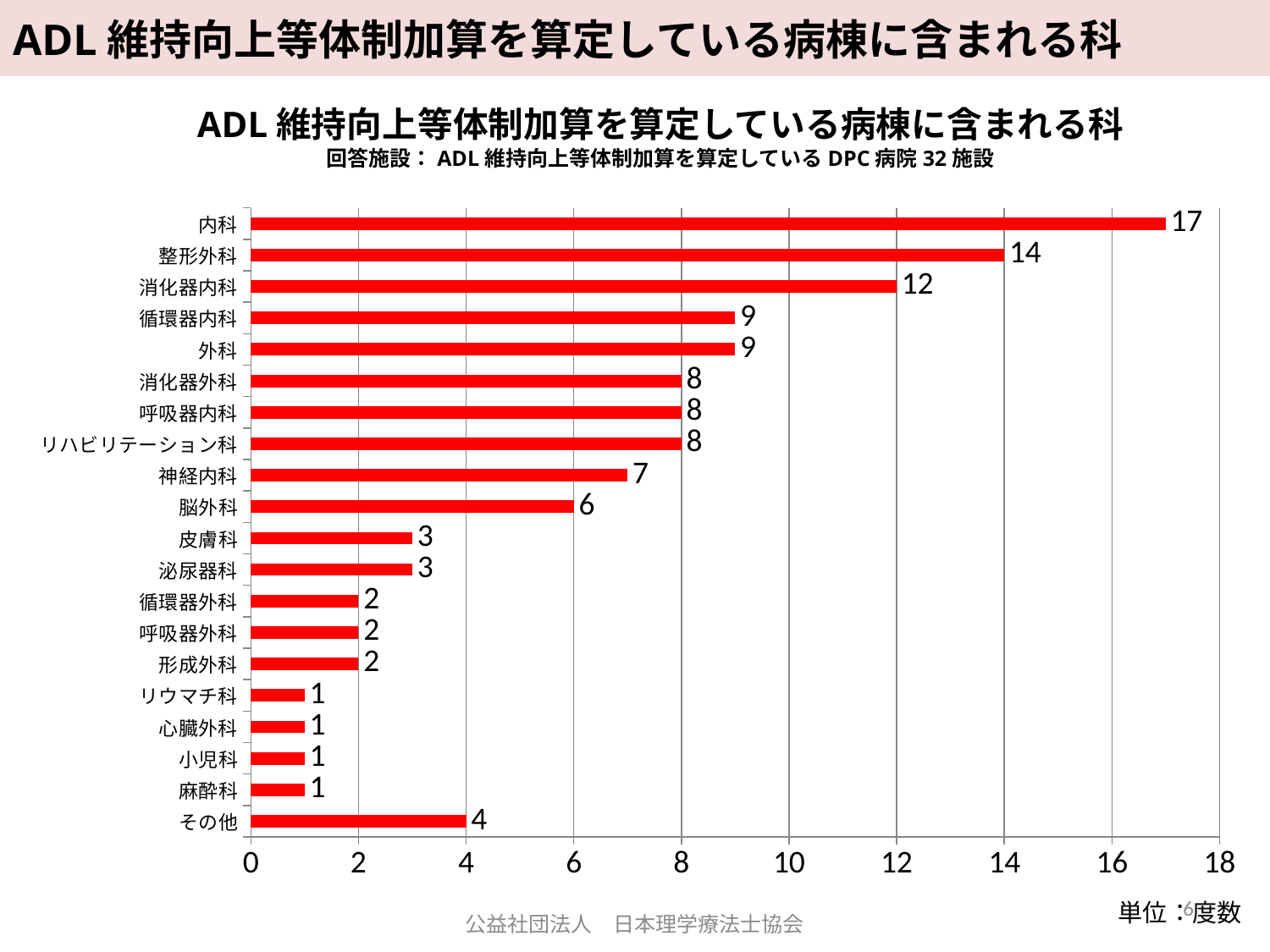
What is the value for 神経内科? 7 What is the value for 消化器内科? 12 What is the maximum value shown on the horizontal axis? 18 What is the value for その他? 4 What kind of chart is shown on the slide? bar chart What is the difference between the values for 脳外科 and 皮膚科? 3 How many categories are shown on the chart? 20 What is the difference between the values for 内科 and 整形外科? 3 Which is larger, the value for その他 or the value for 泌尿器科? その他 Which category has the highest value? 内科 Which is larger, the value for 整形外科 or the value for 消化器内科? 整形外科 What is the value for 内科? 17